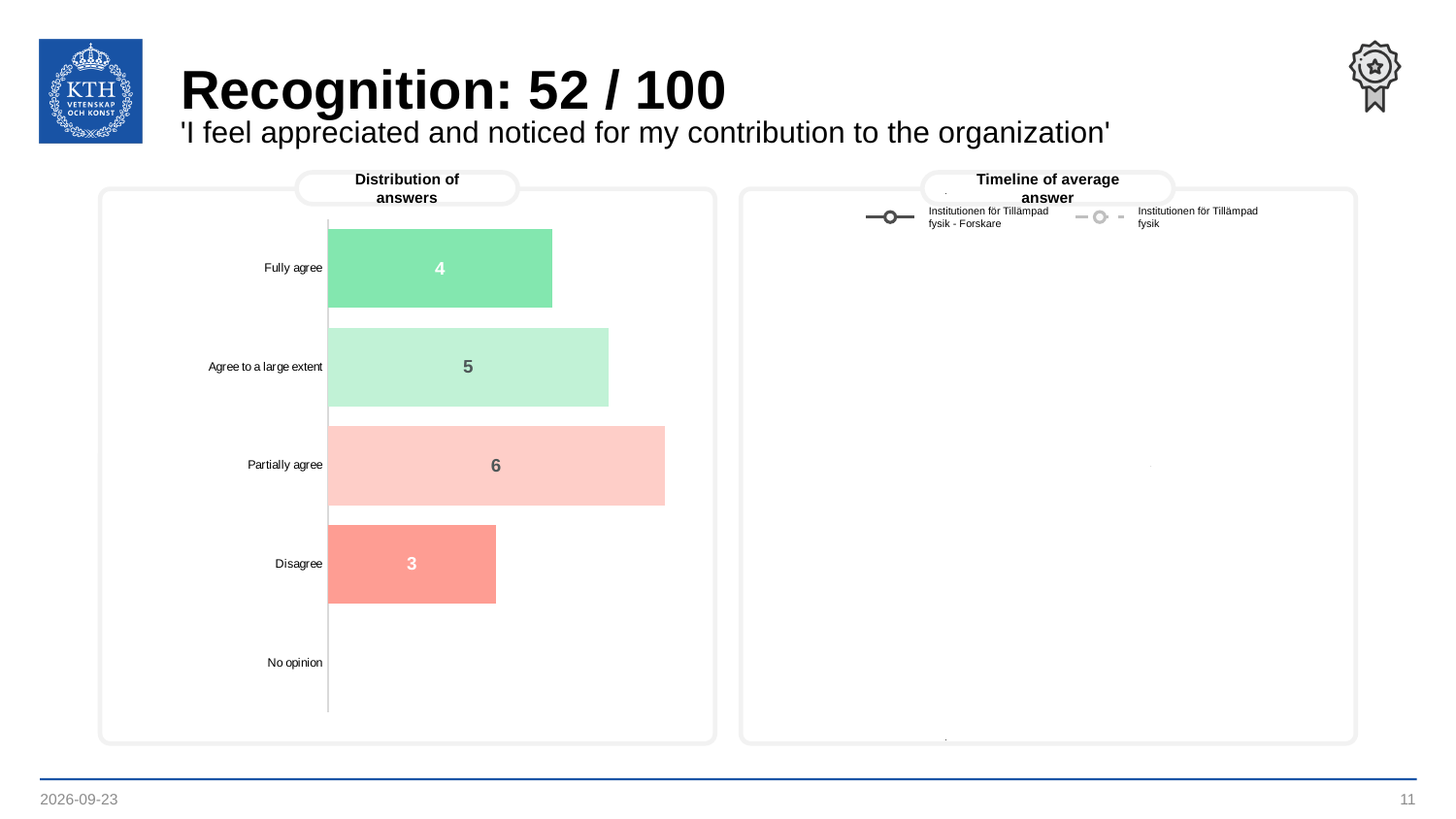
In the 'Distribution of answers' chart, what is the value for 'Fully agree'? 4 In the 'Distribution of answers' chart, which category has no bar drawn? No opinion In the 'Distribution of answers' chart, which category has the highest value? Partially agree What kind of chart is the 'Distribution of answers' chart? Bar chart What is the first legend entry of the 'Timeline of average answer' chart? Institutionen för Tillämpad fysik - Forskare In the 'Distribution of answers' chart, which is larger: the value for 'Fully agree' or the value for 'Agree to a large extent'? Agree to a large extent How many categories are listed on the axis of the 'Distribution of answers' chart? 5 How many series does the legend of the 'Timeline of average answer' chart list? 2 In the 'Distribution of answers' chart, what is the value for 'Disagree'? 3 In the 'Distribution of answers' chart, what is the value for 'Agree to a large extent'? 5 In the 'Distribution of answers' chart, what is the difference between the values for 'Partially agree' and 'Disagree'? 3 In the 'Distribution of answers' chart, what is the value for 'Partially agree'? 6